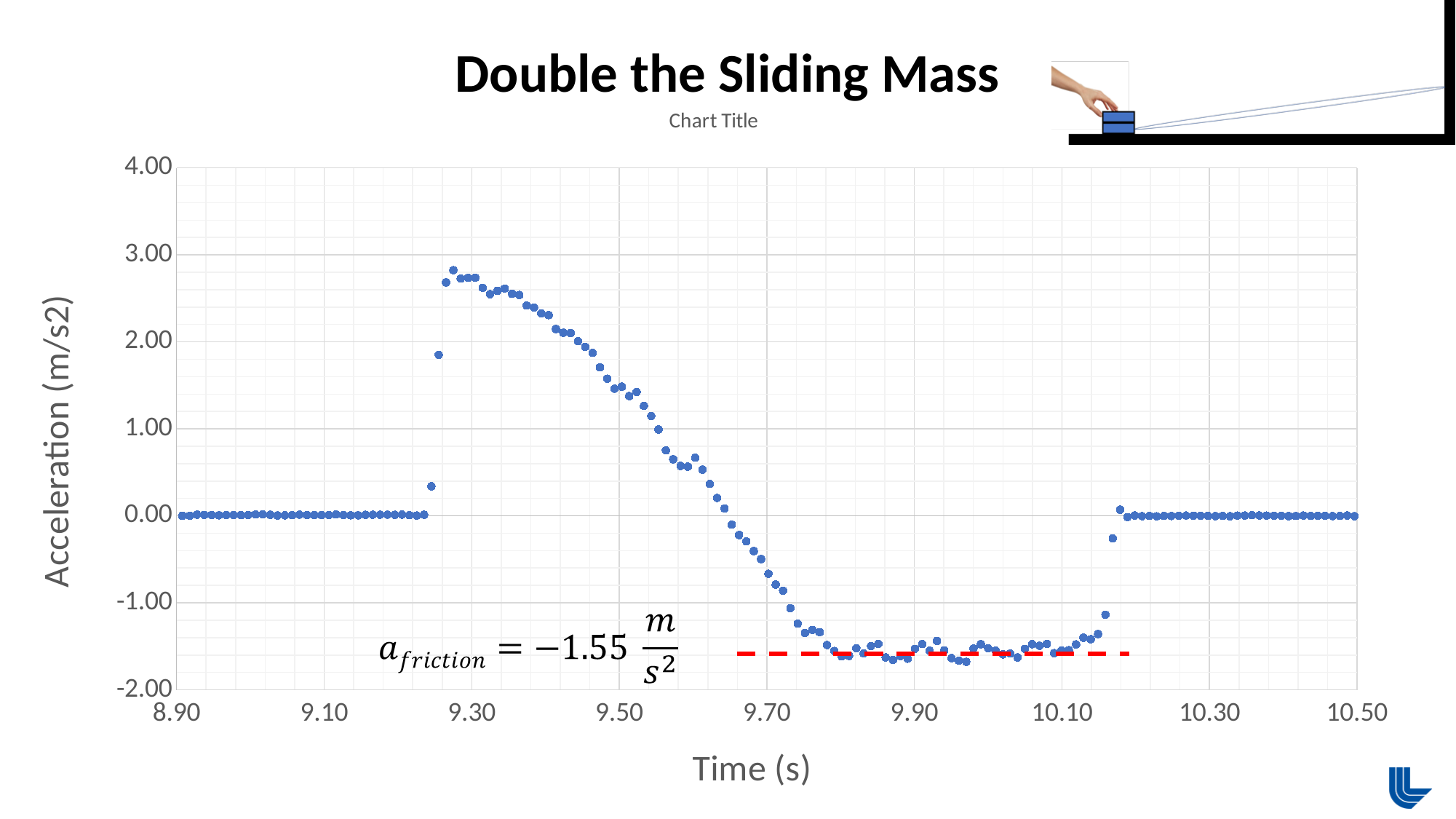
What is the label of the vertical axis of the chart? Acceleration (m/s2) Is the acceleration value at time 9.30 s greater or less than 2.00? greater Is the highest acceleration value plotted greater or less than 3.00? less What value of a_friction is written on the chart? -1.55 m/s^2 Is the acceleration value at time 9.50 s greater or less than 1.00? greater What kind of chart is shown on the slide? scatter chart What is the highest value shown on the vertical axis? 4.00 What is the label of the horizontal axis of the chart? Time (s) Between time 9.30 s and 9.80 s, do the plotted acceleration values rise or fall? fall Which is larger, the acceleration at time 9.40 s or at time 9.60 s? 9.40 s